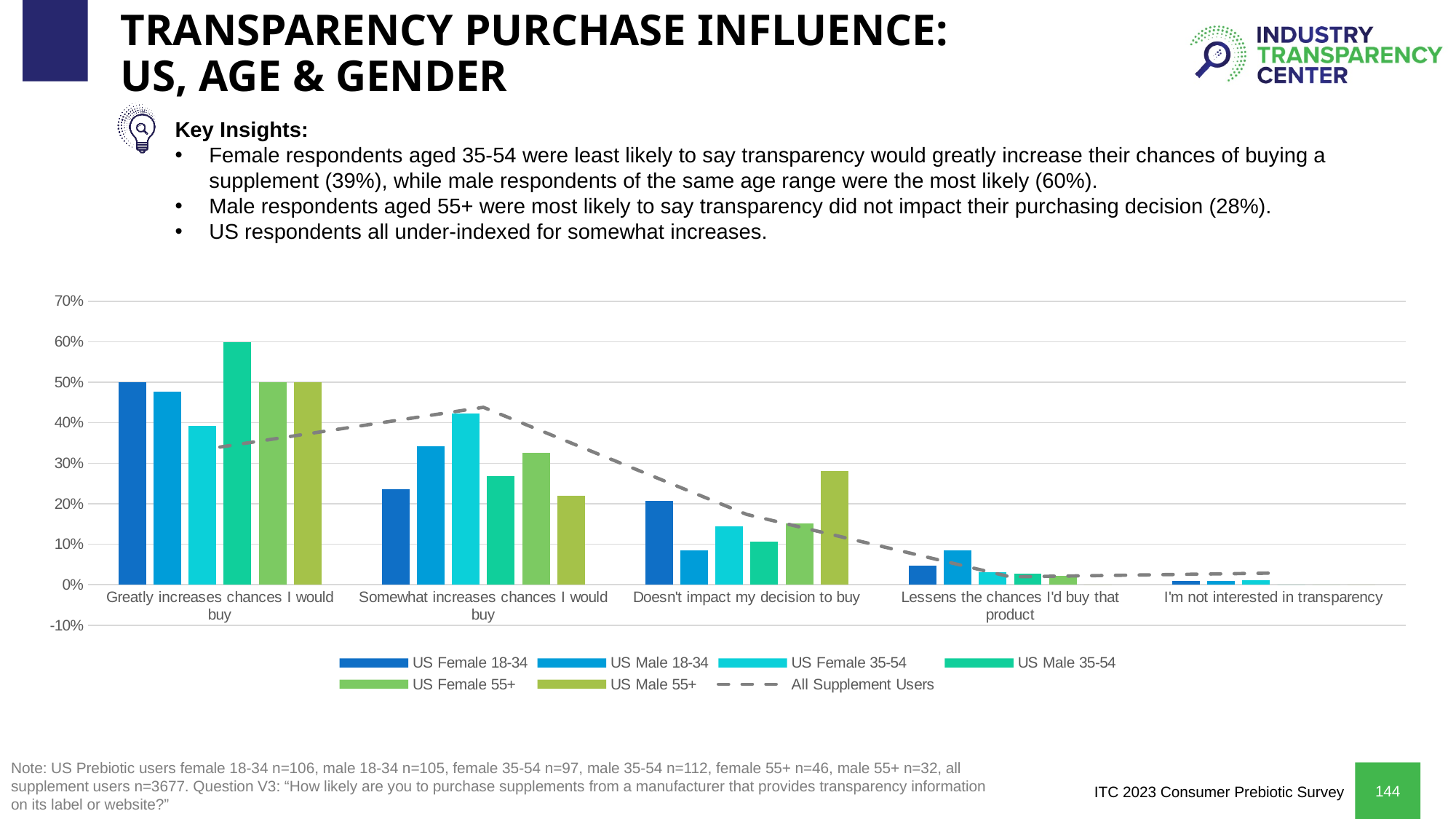
Is the value for US Female 18-34 in the 'Somewhat increases chances I would buy' category greater or less than 30%? less How many categories are shown along the x axis? 5 What is the value for US Male 35-54 in the 'Greatly increases chances I would buy' category? 60% What is the value for US Female 35-54 in the 'Greatly increases chances I would buy' category? 39% What is the difference between US Male 35-54 and US Female 35-54 in the 'Greatly increases chances I would buy' category? 21 percentage points What is the value for US Male 55+ in the 'Doesn't impact my decision to buy' category? 28% What kind of chart is shown on the slide? combination bar and line chart In the 'Doesn't impact my decision to buy' category, which is larger: US Female 18-34 or US Male 18-34? US Female 18-34 Does the All Supplement Users dashed line rise or fall from 'Somewhat increases chances I would buy' to 'I'm not interested in transparency'? fall In the 'Greatly increases chances I would buy' category, which series has the lowest bar? US Female 35-54 In the 'Greatly increases chances I would buy' category, which series has the highest bar? US Male 35-54 How many series does the legend list? 7